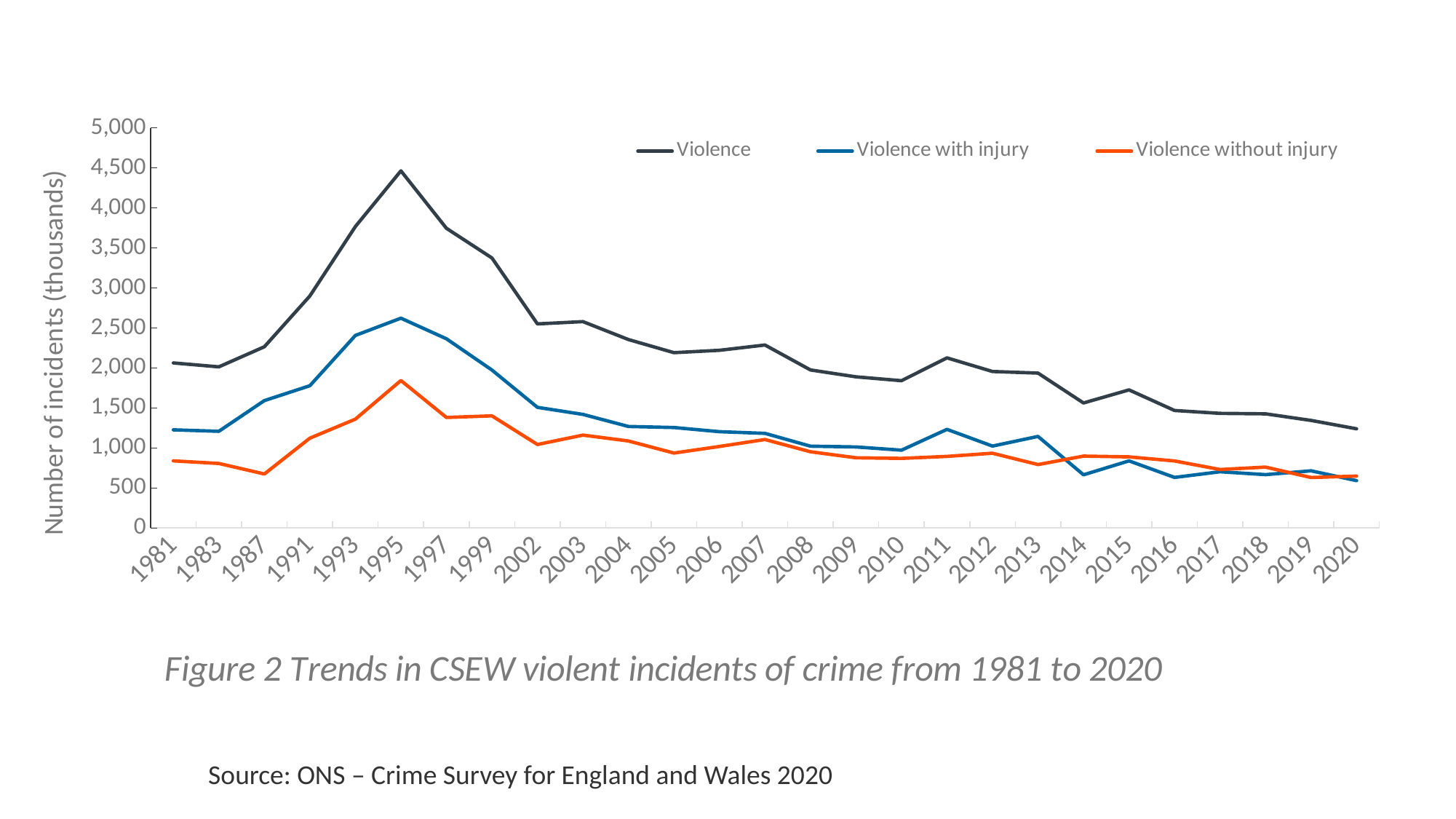
In which year does the Violence series reach its lowest value? 2020 In 2014, which is larger: Violence with injury or Violence without injury? Violence without injury Is the value for Violence in 1995 greater or less than 4,000? greater Does the Violence series rise or fall between 1995 and 2020? fall Is the value for Violence without injury in 1995 greater or less than 1,500? greater How many series does the legend list? 3 In 1995, which is larger: Violence with injury or Violence without injury? Violence with injury In which year does the Violence without injury series reach its highest value? 1995 Is the value for Violence in 2020 greater or less than 1,500? less What kind of chart is shown on the slide? line chart How many years are plotted along the x axis? 27 In which year does the Violence series reach its highest value? 1995